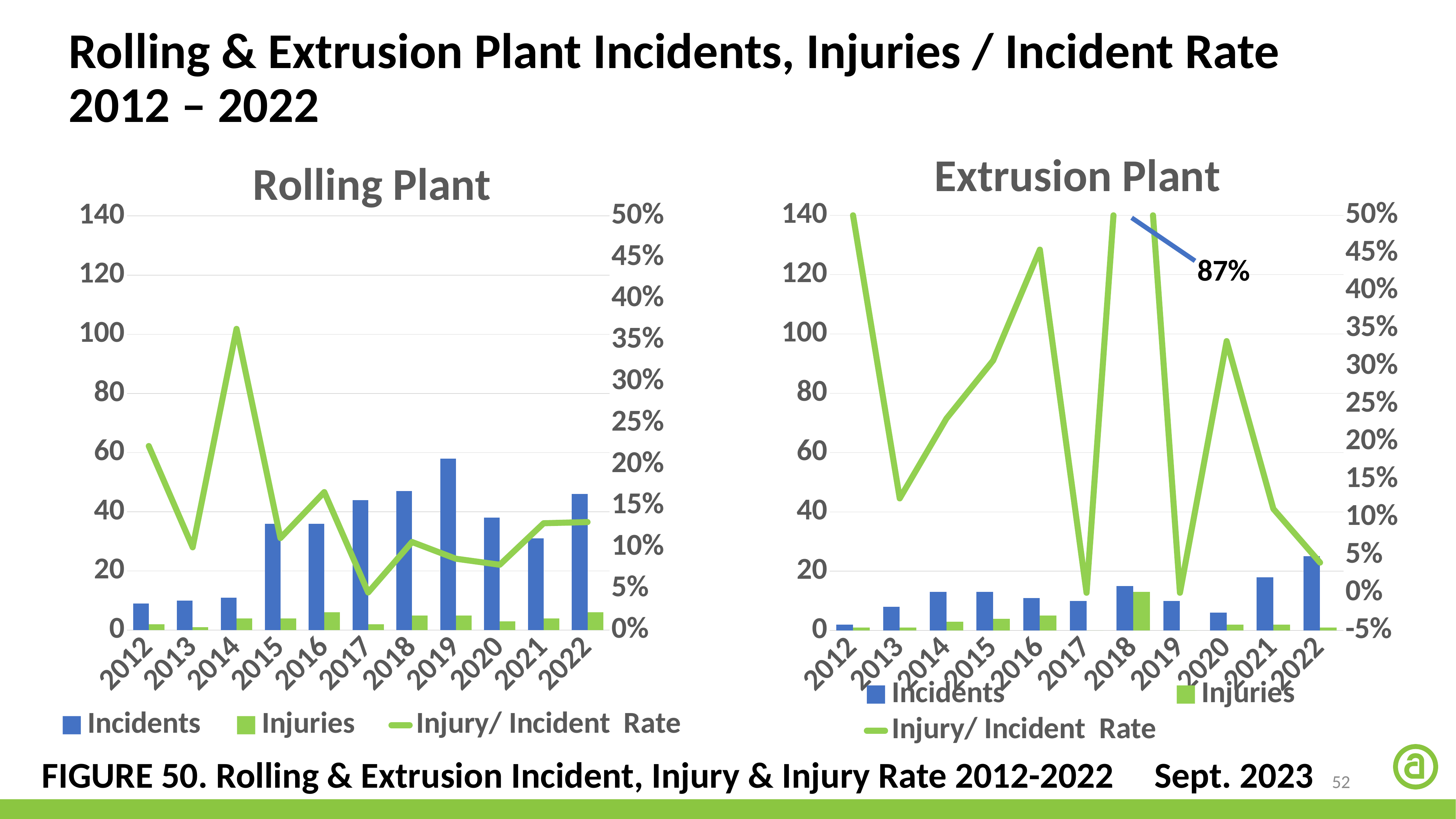
In the Rolling Plant chart, is the number of Incidents in 2019 greater or less than 40? greater In the Rolling Plant chart, which year has the highest number of Incidents? 2019 In the Extrusion Plant chart, is the Injury/ Incident Rate in 2012 greater or less than 40%? greater In the Extrusion Plant chart, which year has the highest number of Incidents? 2022 How many years are shown on the x axis of the Rolling Plant chart? 11 In the Rolling Plant chart, is the number of Incidents in 2012 greater or less than 20? less What kind of chart is the Rolling Plant chart? A combined bar and line chart In the Rolling Plant chart, which year has the highest Injury/ Incident Rate? 2014 How many series does the legend of the Rolling Plant chart list? 3 In the Rolling Plant chart, which year has more Incidents, 2015 or 2019? 2019 What percentage value is annotated with an arrow on the Extrusion Plant chart? 87%